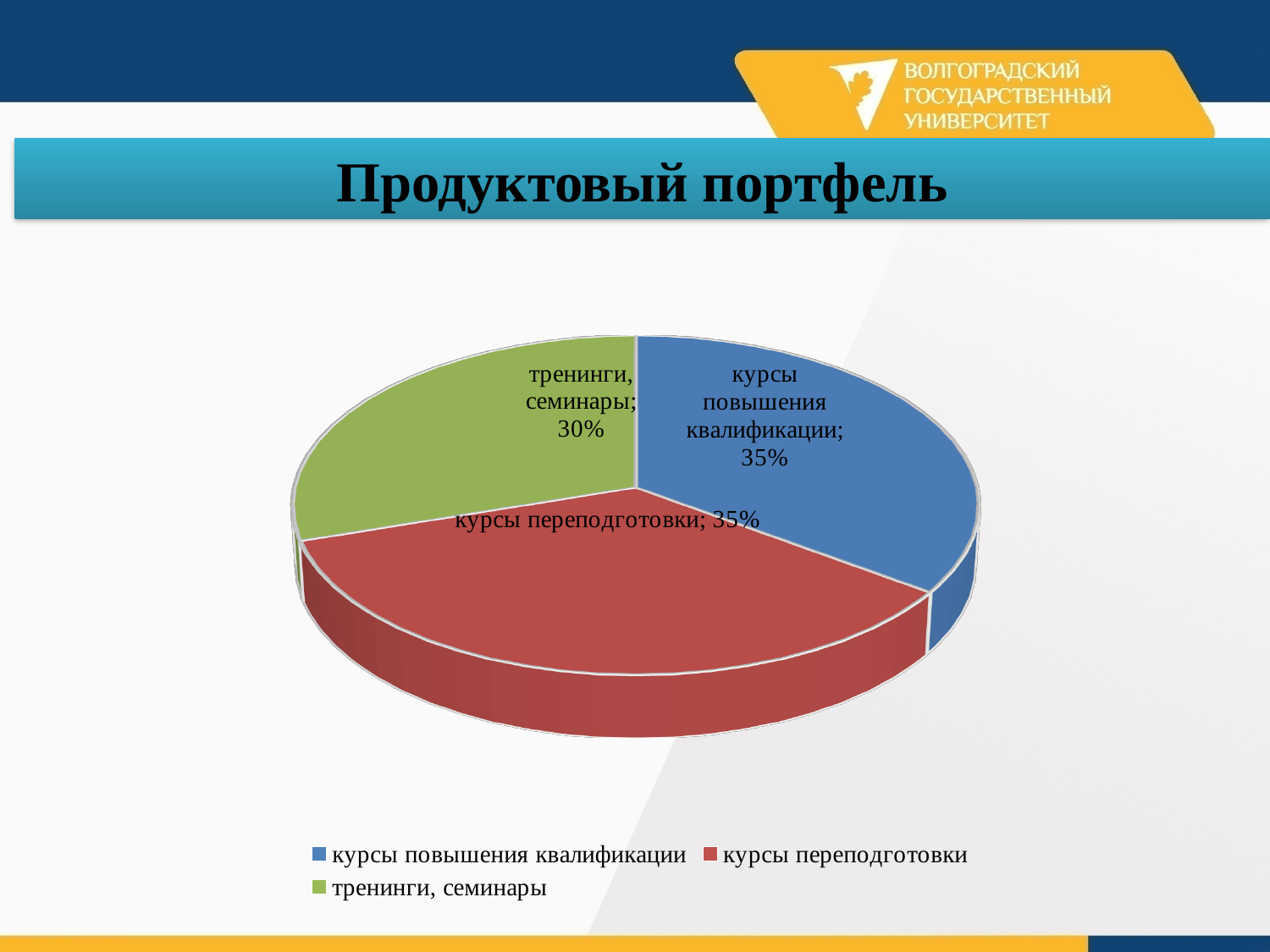
By how many percentage points does the share for курсы переподготовки exceed the share for тренинги, семинары? 5 What share of the pie is labelled for курсы переподготовки? 35% What share of the pie is labelled for тренинги, семинары? 30% Do курсы повышения квалификации and курсы переподготовки have the same share of the pie? yes Which category has the smallest share of the pie? тренинги, семинары How many entries does the legend list? 3 Which colour represents тренинги, семинары in the pie chart? green Which is larger: the share for курсы повышения квалификации or the share for тренинги, семинары? курсы повышения квалификации How many slices does the pie chart have? 3 What share of the pie is labelled for курсы повышения квалификации? 35% What kind of chart is shown on the slide? pie chart What is the title of the slide's chart? Продуктовый портфель